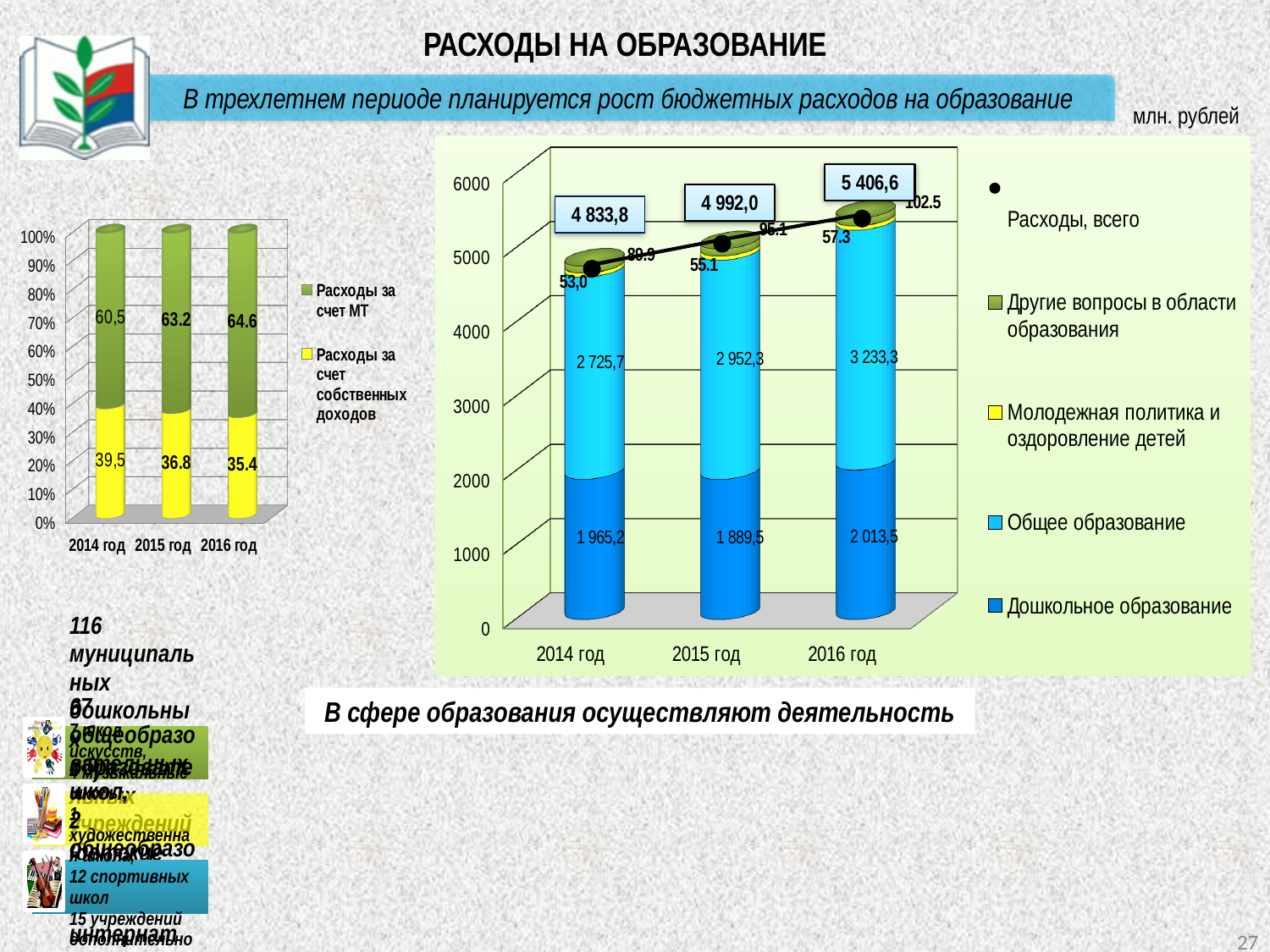
On the left chart, which year has the highest share of Расходы за счет МТ? 2016 год On the right chart, do the total expenditures rise or fall from 2014 год to 2016 год? rise On the right chart, what is the difference between the total expenditure in 2016 год and 2014 год? 572,8 On the left chart, what is the share of Расходы за счет собственных доходов in 2014 год? 39,5 On the right chart, is the value for Общее образование larger in 2016 год or in 2014 год? 2016 год On the right chart, how many series does the legend list? 5 On the right chart, what is the value for Дошкольное образование in 2014 год? 1 965,2 On the right chart, what is the value for Общее образование in 2015 год? 2 952,3 On the right chart, what is the total expenditure (Расходы, всего) for 2016 год? 5 406,6 On the right chart, which year has the highest total expenditure? 2016 год What kind of chart is the left chart? bar chart On the right chart, which year has the lowest value for Дошкольное образование? 2015 год